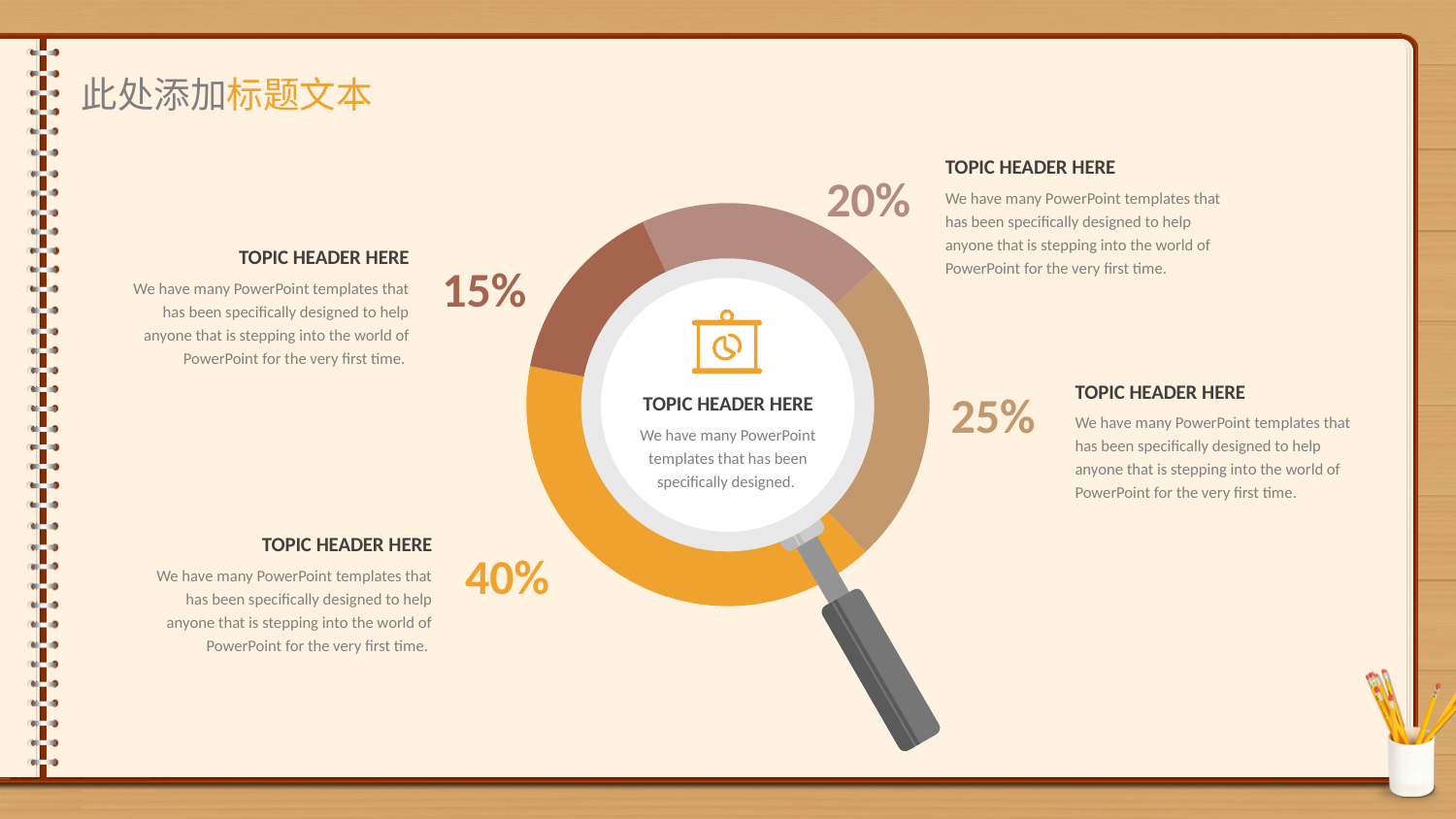
How many segments does the donut chart have? 4 What do the four percentages on the donut chart add up to? 100% What is the largest percentage shown on the donut chart? 40% What percentage is labelled on the dark brown segment at the upper left of the donut chart? 15% What is the smallest percentage shown on the donut chart? 15% Which is larger, the 25% segment or the 20% segment of the donut chart? The 25% segment What percentage is labelled on the orange segment of the donut chart? 40% What percentage is labelled on the segment at the right side of the donut chart? 25% What is the difference between the largest and smallest percentages on the donut chart? 25 percentage points What kind of chart is shown on the slide? Donut (pie) chart What percentage is labelled on the segment at the top of the donut chart? 20% What text appears in the centre of the donut chart as the header? TOPIC HEADER HERE